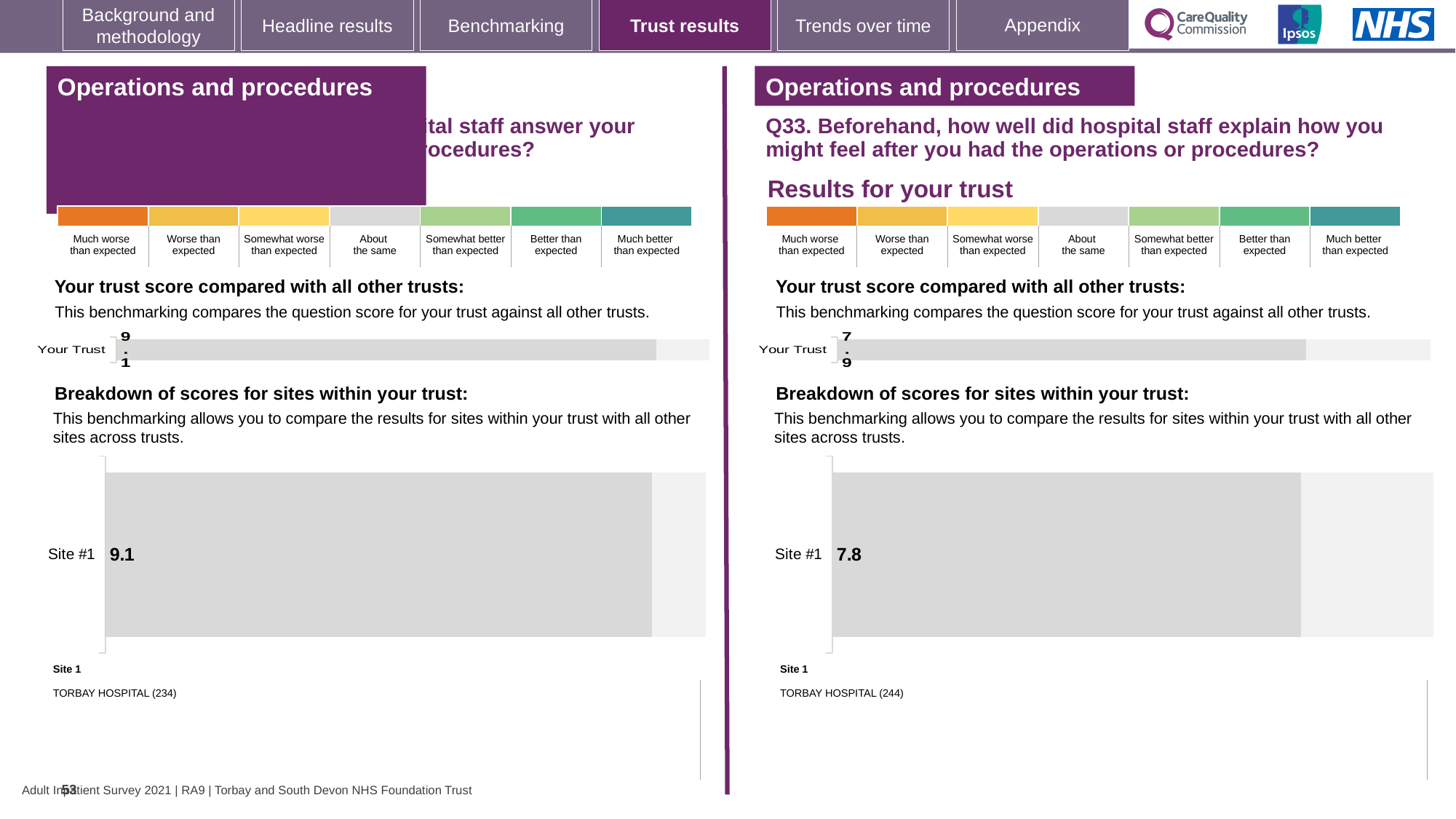
On the left panel, what is the score shown for 'Your Trust' in the 'Your trust score compared with all other trusts' chart? 9.1 On the left panel, what is the score shown for Site #1 in the 'Breakdown of scores for sites within your trust' chart? 9.1 How many sites are shown in the 'Breakdown of scores for sites within your trust' chart on the left panel? 1 Which is larger: the Site #1 score on the left panel or the Site #1 score on the right panel (Q33)? Left panel (9.1) What kind of chart is used to show the Site #1 score on the right panel (Q33)? Bar chart On the right panel (Q33), what is the score shown for 'Your Trust' in the 'Your trust score compared with all other trusts' chart? 7.9 What is the difference between the Site #1 score on the left panel and the Site #1 score on the right panel (Q33)? 1.3 On the right panel (Q33), what is the score shown for Site #1 in the 'Breakdown of scores for sites within your trust' chart? 7.8 Which is larger: the 'Your Trust' score on the left panel or the 'Your Trust' score on the right panel (Q33)? Left panel (9.1) On the right panel (Q33), what is the difference between the 'Your Trust' score and the Site #1 score? 0.1 On the right panel (Q33), which site name is listed as Site 1 below the chart? TORBAY HOSPITAL (244) On the left panel, which site name is listed as Site 1 below the chart? TORBAY HOSPITAL (234)